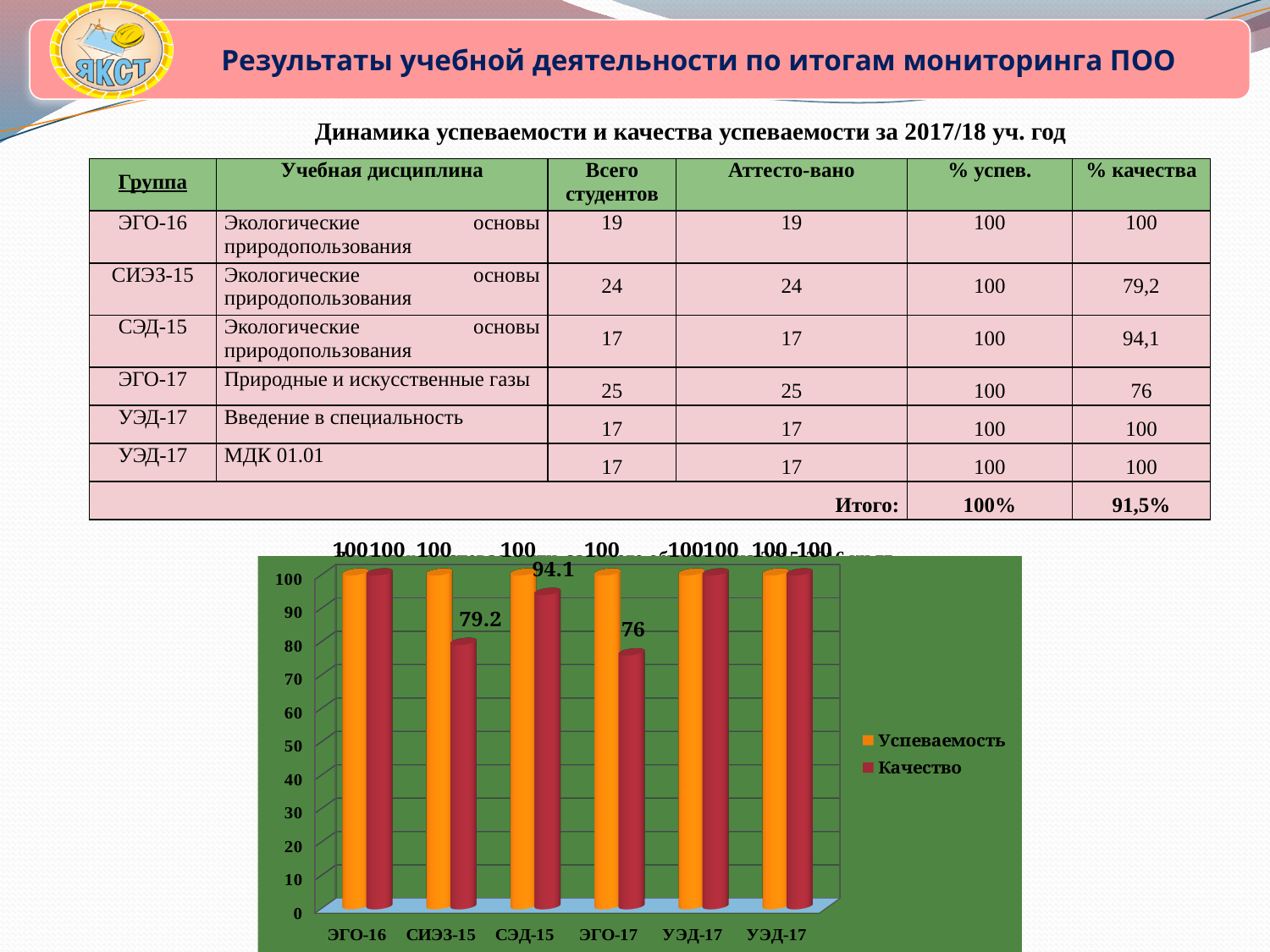
How many series does the chart legend list? 2 What is the Качество value for СЭД-15 in the chart? 94.1 What is the difference between the Успеваемость and Качество values for ЭГО-17 in the chart? 24 What is the Успеваемость value for ЭГО-16 in the chart? 100 What type of chart is shown on the slide? bar chart Which category has the lowest Качество value in the chart? ЭГО-17 Which series in the chart is shown in orange? Успеваемость What is the Качество value for ЭГО-17 in the chart? 76 What is the Качество value for СИЭЗ-15 in the chart? 79.2 Is the Качество value for ЭГО-17 in the chart greater or less than 80? less Which is larger in the chart: the Качество value for СИЭЗ-15 or for СЭД-15? СЭД-15 How many category groups are shown on the x axis of the chart? 6